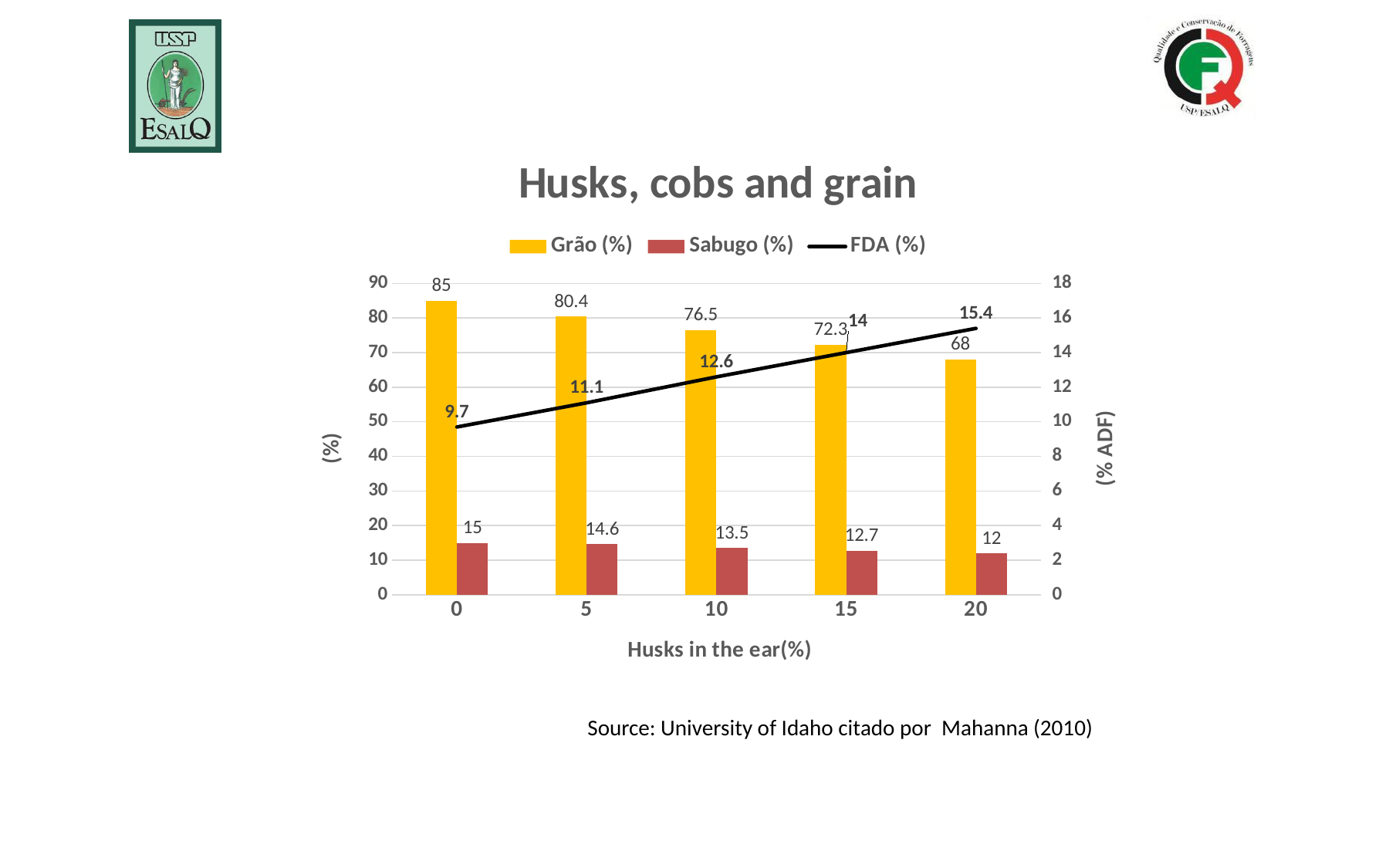
What is the Grão (%) value when husks in the ear is 0%? 85 How many series does the legend list? 3 At which husks-in-the-ear level is FDA (%) highest? 20 What is the Sabugo (%) value when husks in the ear is 10%? 13.5 Which is larger, the Grão (%) value at 5% husks or at 15% husks? 5% husks What is the FDA (%) value when husks in the ear is 20%? 15.4 What is the difference between the Grão (%) values at 0% and 20% husks in the ear? 17 What is the title of the chart? Husks, cobs and grain What is the difference between the Sabugo (%) values at 5% and 15% husks in the ear? 1.9 How many husks-in-the-ear levels are shown on the x axis? 5 At which husks-in-the-ear level is Grão (%) lowest? 20 How does FDA (%) change as husks in the ear increases from 0% to 20%? It rises